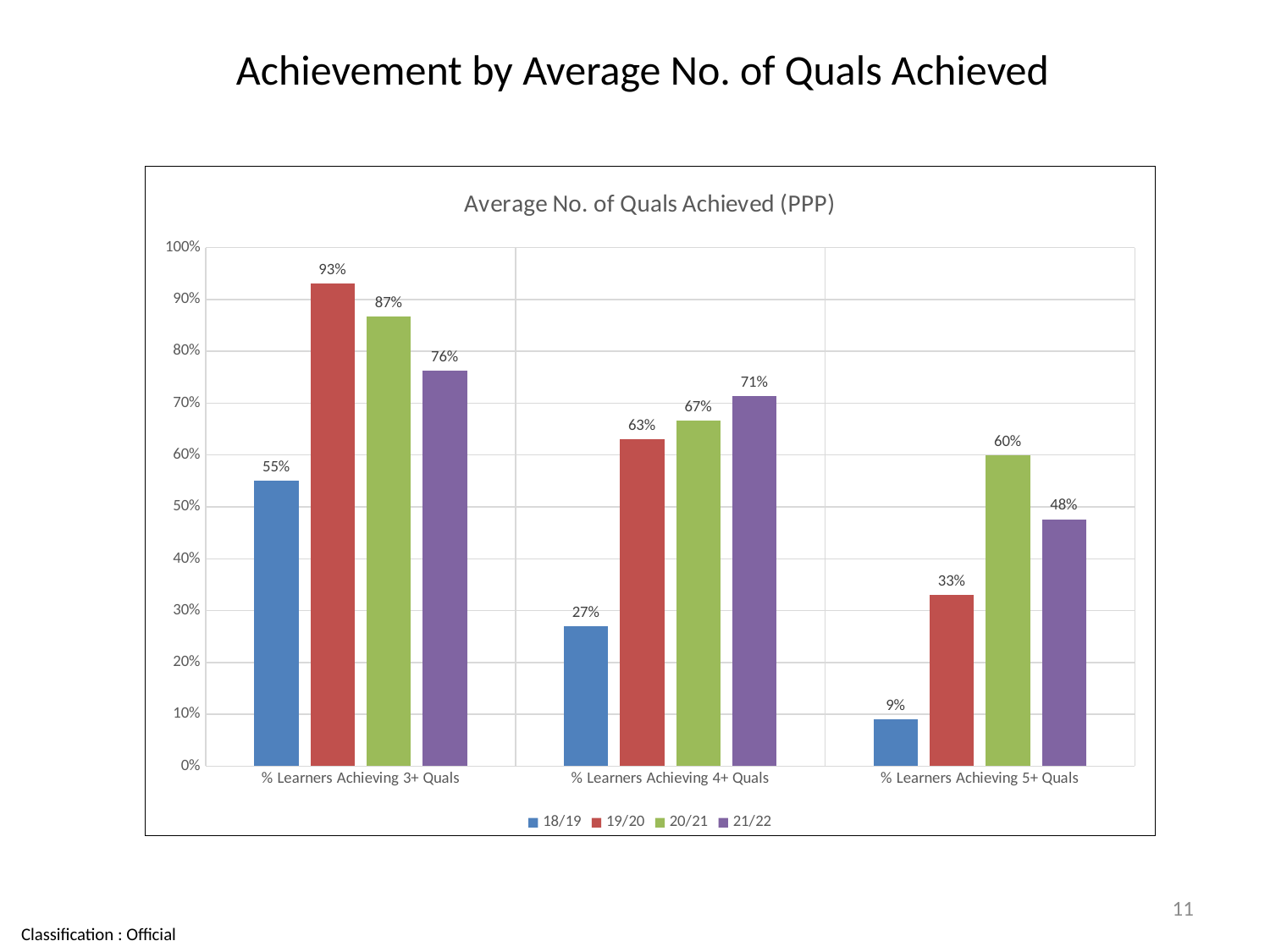
Is the 19/20 value for % Learners Achieving 5+ Quals greater or less than 40%? less How many series does the legend list? 4 What is the difference between the 19/20 and 18/19 values in the % Learners Achieving 3+ Quals category? 38% What is the value for 19/20 in the % Learners Achieving 3+ Quals category? 93% What is the value for 21/22 in the % Learners Achieving 4+ Quals category? 71% What is the value for 18/19 in the % Learners Achieving 5+ Quals category? 9% Which series has the lowest value in the % Learners Achieving 4+ Quals category? 18/19 How many categories are shown on the x axis? 3 Which series has the highest value in the % Learners Achieving 5+ Quals category? 20/21 What kind of chart is shown on the slide? Bar chart Which is larger: the 20/21 value for % Learners Achieving 5+ Quals or the 21/22 value for % Learners Achieving 5+ Quals? 20/21 What is the title of the chart? Average No. of Quals Achieved (PPP)